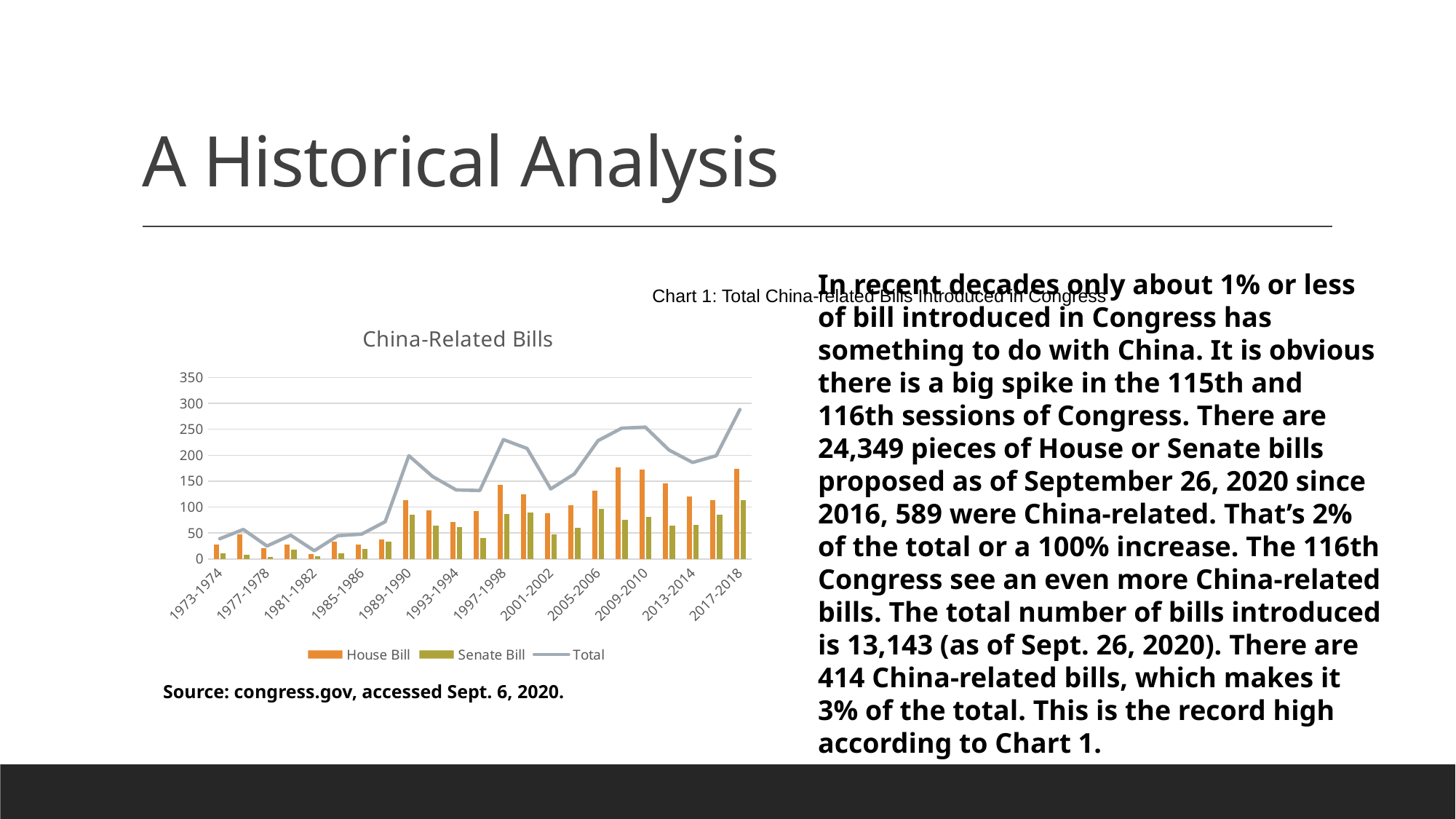
In which period is the Senate Bill bar the tallest? 2017-2018 Is the Total value for 1981-1982 greater or less than 100? less Which series in the chart is drawn as a line rather than bars? Total Is the Senate Bill value for 2017-2018 greater or less than 100? greater Is the Total value for 2017-2018 greater or less than 250? greater What is the title of the chart on the slide? China-Related Bills In which period does the Total line reach its highest value? 2017-2018 In 2017-2018, which is larger, the House Bill value or the Senate Bill value? House Bill What kind of chart is shown on the slide? Combined bar and line chart How many series does the chart's legend list? 3 Overall, does the Total line rise or fall from 1973-1974 to 2017-2018? rise